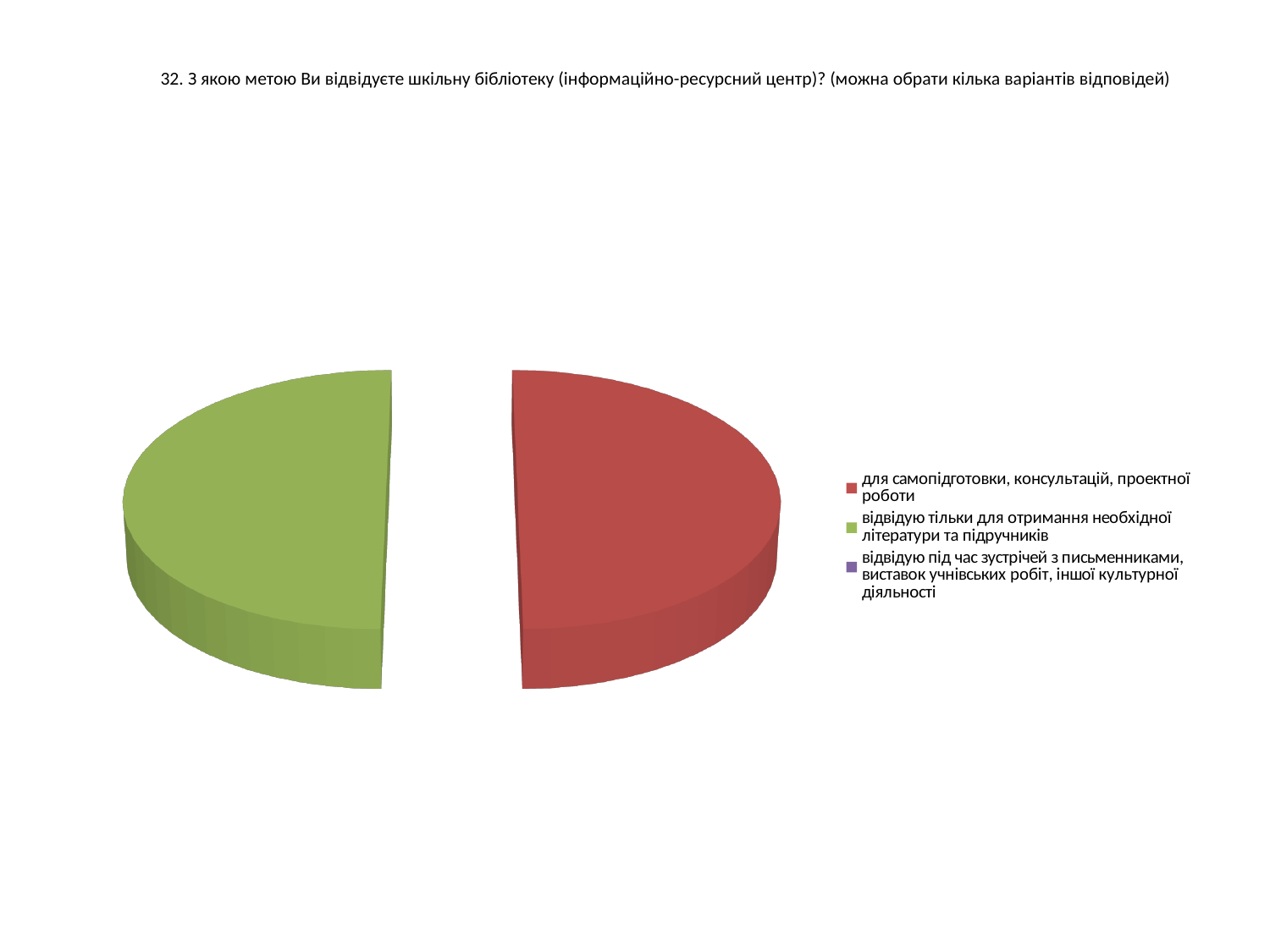
Which legend category has no visible slice in the pie chart? відвідую під час зустрічей з письменниками, виставок учнівських робіт, іншої культурної діяльності Which colour represents the category "для самопідготовки, консультацій, проектної роботи" in the pie chart? red How many entries does the legend of the pie chart list? 3 Which legend entry is shown in green in the pie chart? відвідую тільки для отримання необхідної літератури та підручників What kind of chart is shown on the slide? pie chart How many slices are visible in the pie chart? 2